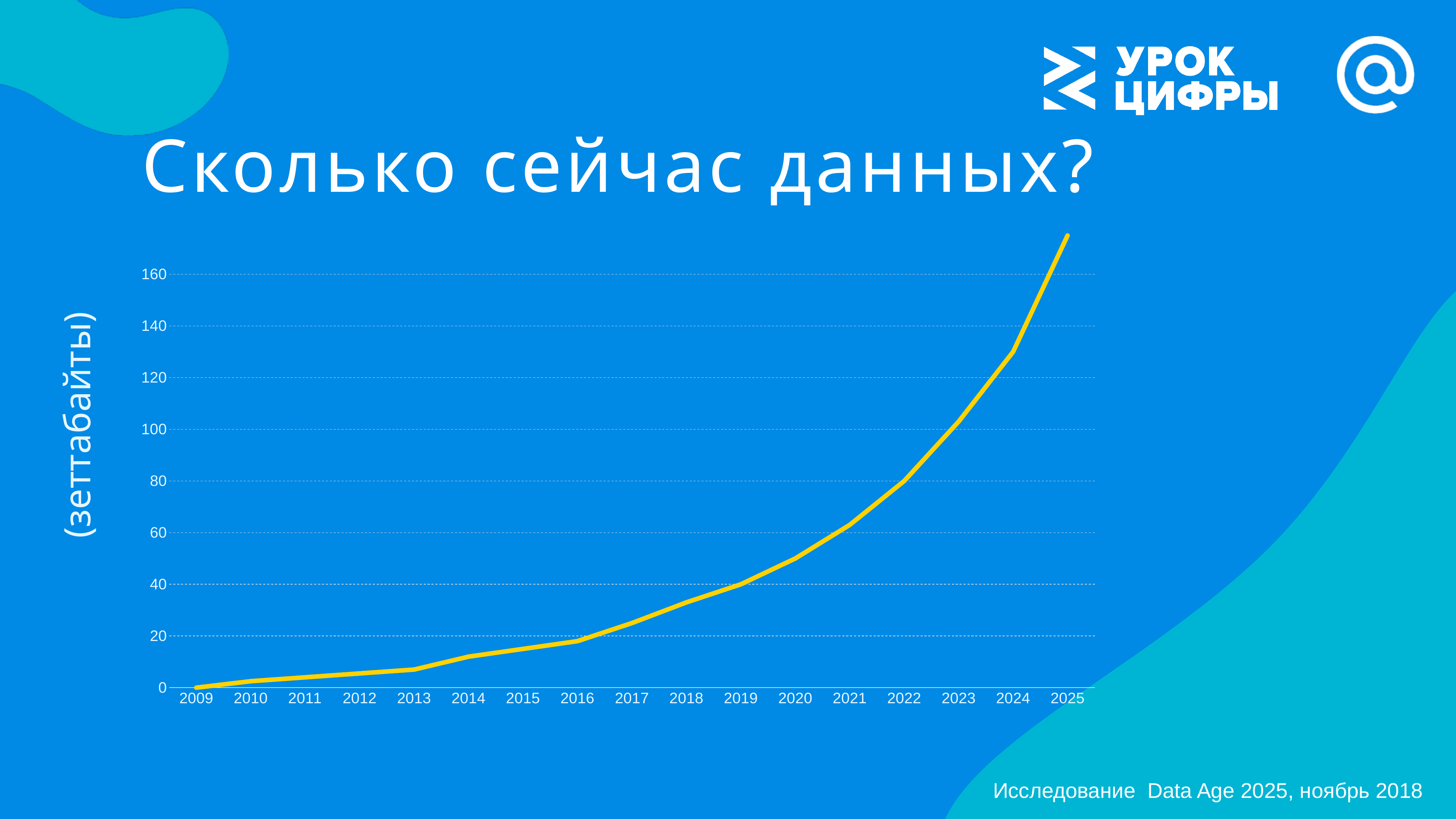
How many years are plotted along the x axis of the chart? 17 What kind of chart is shown on the slide? line chart Is the value for 2024 greater or less than 120? greater Is the value for 2025 greater or less than 160? greater Do the values on the chart rise or fall from 2009 to 2025? rise Which year has the lowest value on the chart? 2009 Is the value for 2020 greater or less than 40? greater What is the title of the slide above the chart? Сколько сейчас данных? Which year has the larger value, 2018 or 2023? 2023 Which year has the highest value on the chart? 2025 What unit is given on the vertical axis label of the chart? зеттабайты